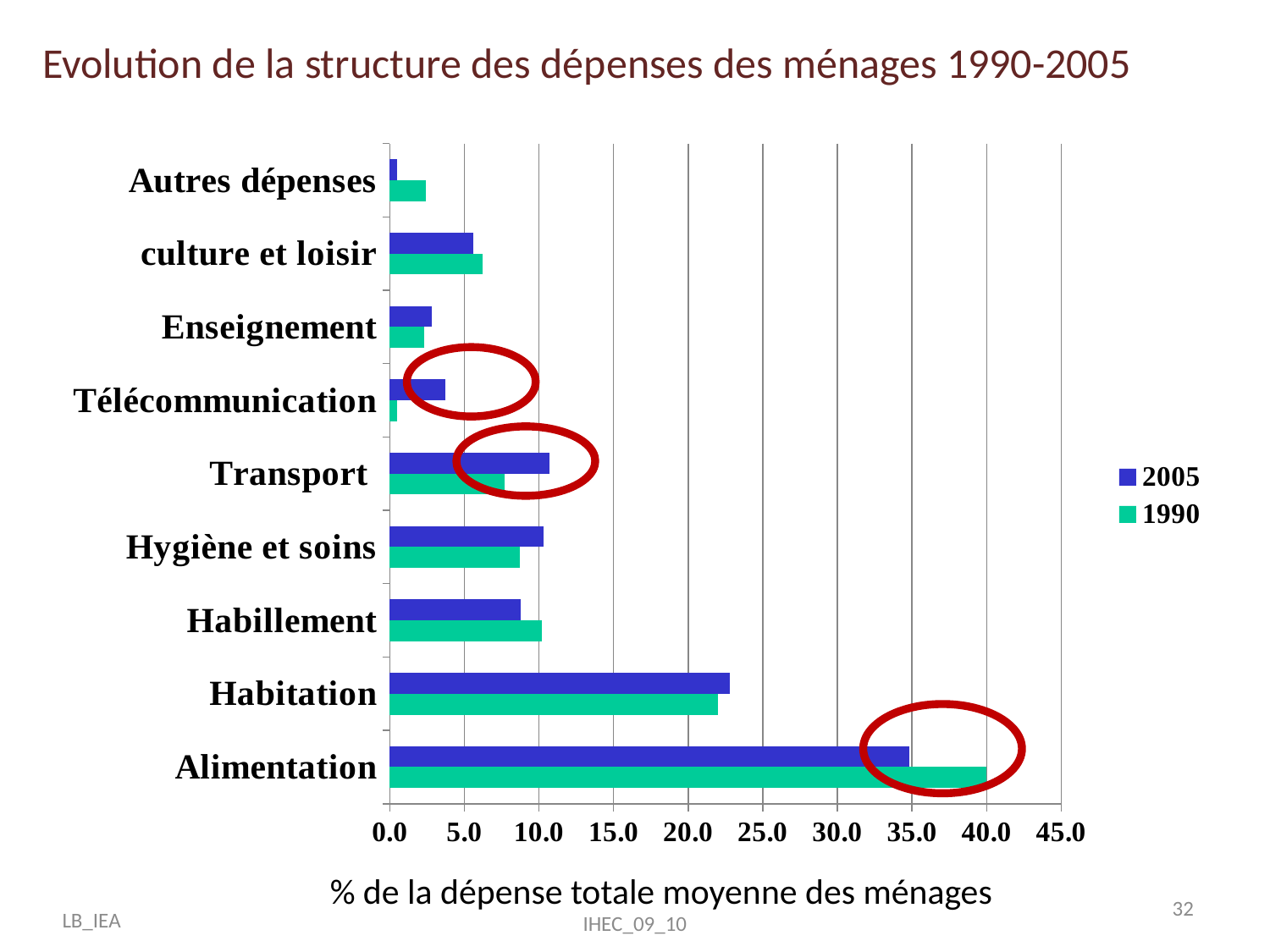
What is the label of the horizontal axis? % de la dépense totale moyenne des ménages Which category has the highest value for 1990? Alimentation How many series does the legend list? 2 Is the 2005 value for Habitation greater or less than 20.0? greater How many categories of expenditure are shown on the chart? 9 For Transport, which year has the larger value, 1990 or 2005? 2005 For Alimentation, which year has the larger value, 1990 or 2005? 1990 Which category has the highest value for 2005? Alimentation Is the 1990 value for Télécommunication greater or less than 5.0? less What kind of chart is shown on the slide? bar chart Which category has the lowest value for 1990? Télécommunication Is the 2005 value for Alimentation greater or less than 30.0? greater